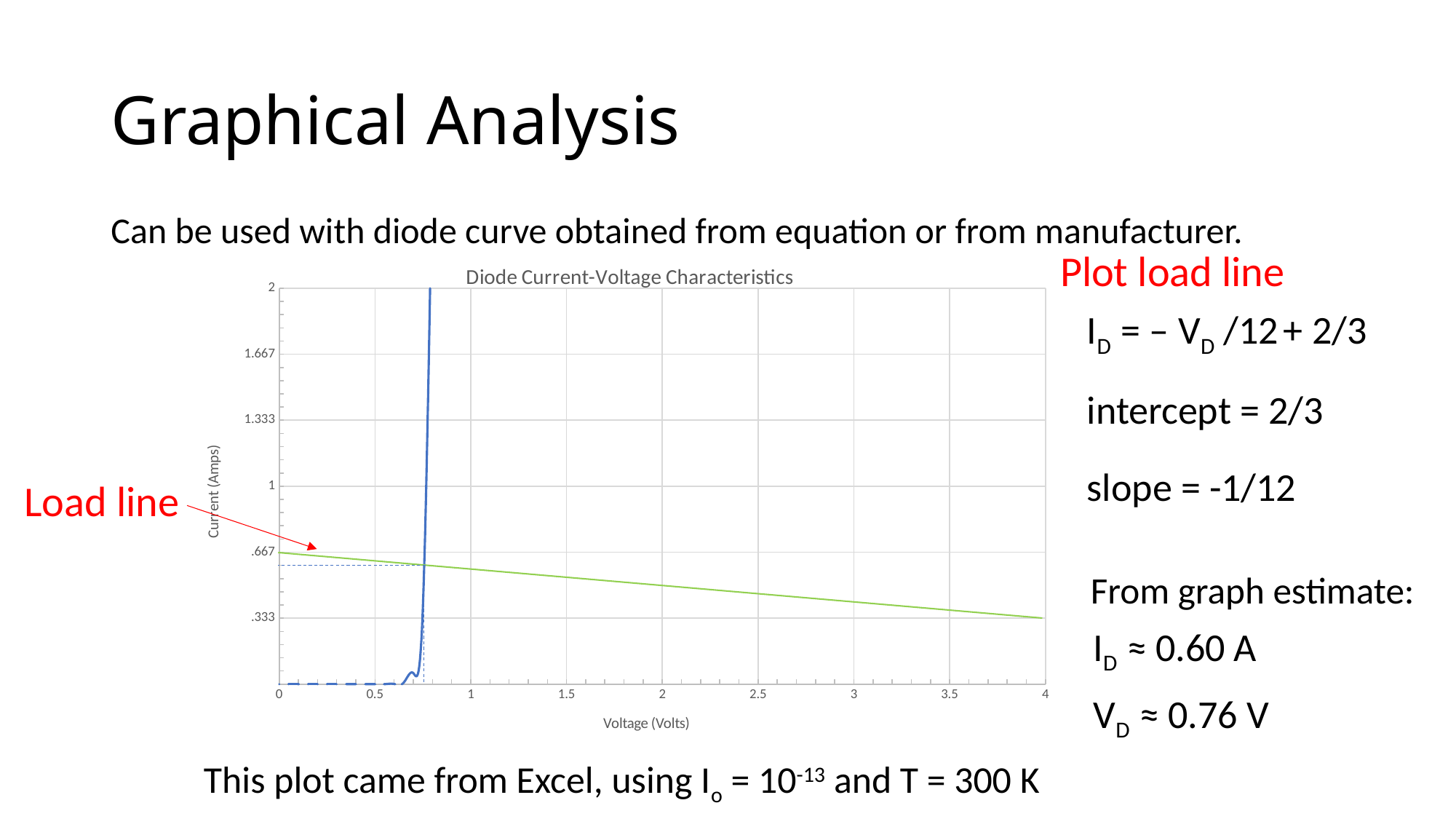
How many lines are plotted on the chart? 2 What kind of chart is shown on the slide? line chart At 0.5 volts, which line has the larger current, the green load line or the blue diode curve? green load line Does the green load line rise or fall as voltage increases along the x axis? fall What is the label of the x axis of the chart? Voltage (Volts) What is the current value of the green load line at 4 volts? .333 What is the highest value shown on the x axis of the chart? 4 Is the value of the green load line at 2 volts greater or less than .667? less What is the title of the chart? Diode Current-Voltage Characteristics What is the current value of the green load line at 0 volts? .667 Is the current of the blue diode curve at 0.5 volts greater or less than .333? less Is the value of the green load line at 2 volts greater or less than .333? greater